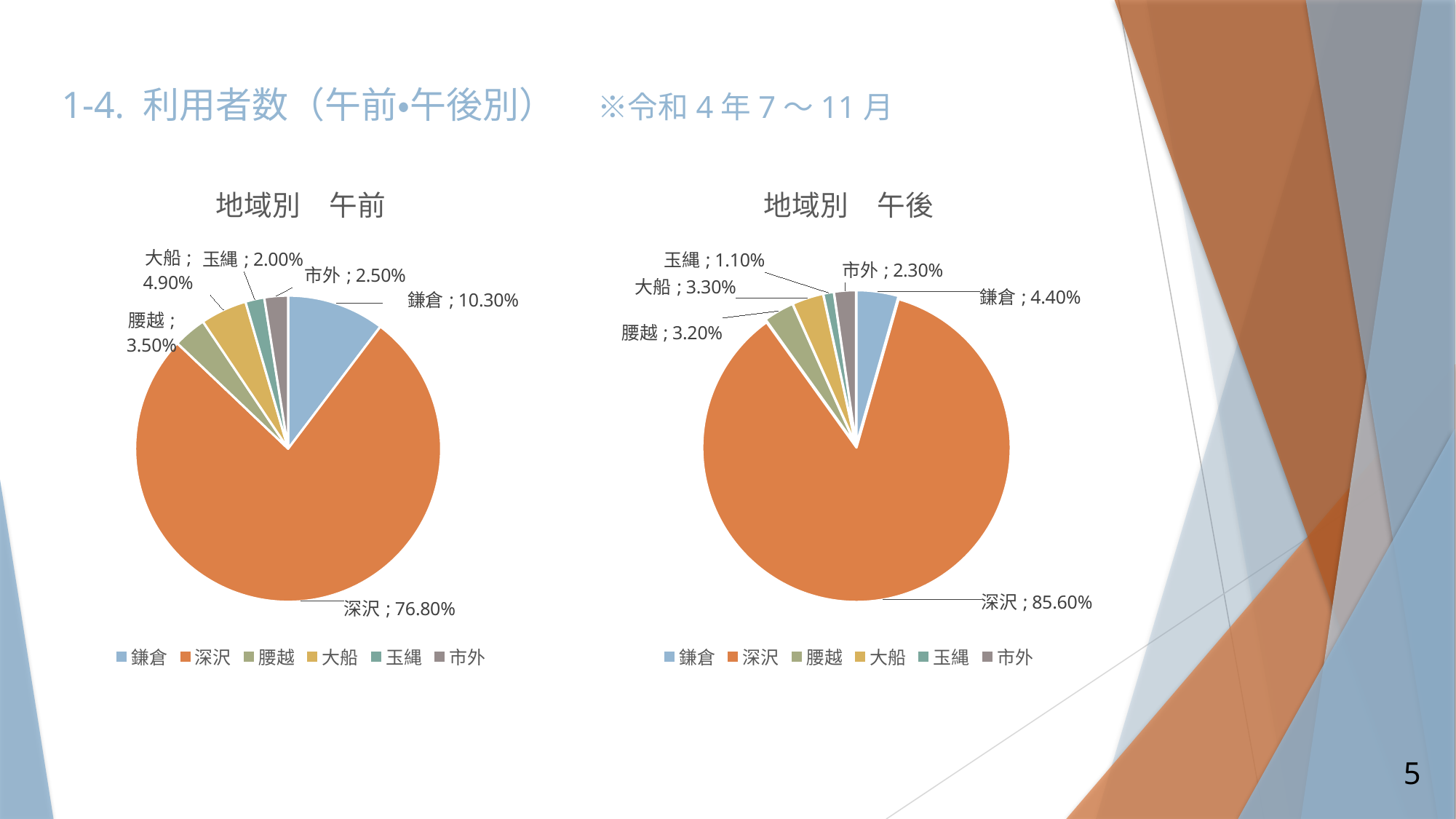
In the 地域別 午前 chart, which region has the smallest slice? 玉縄 In the 地域別 午後 chart, what share does 鎌倉 have? 4.40% What is the difference between the 深沢 share in the 地域別 午後 chart and the 深沢 share in the 地域別 午前 chart? 8.80% In the 地域別 午前 chart, which region has the largest slice? 深沢 How many entries does the legend of the 地域別 午前 chart list? 6 In the 地域別 午前 chart, which is larger, the share for 大船 or the share for 腰越? 大船 In the 地域別 午後 chart, what share does 市外 have? 2.30% In the 地域別 午前 chart, what share does 深沢 have? 76.80% What type of chart is 地域別 午前? Pie chart How many slices does the 地域別 午後 pie chart have? 6 In the 地域別 午後 chart, which region has the smallest slice? 玉縄 In the 地域別 午前 chart, what is the difference between the shares of 鎌倉 and 市外? 7.80%